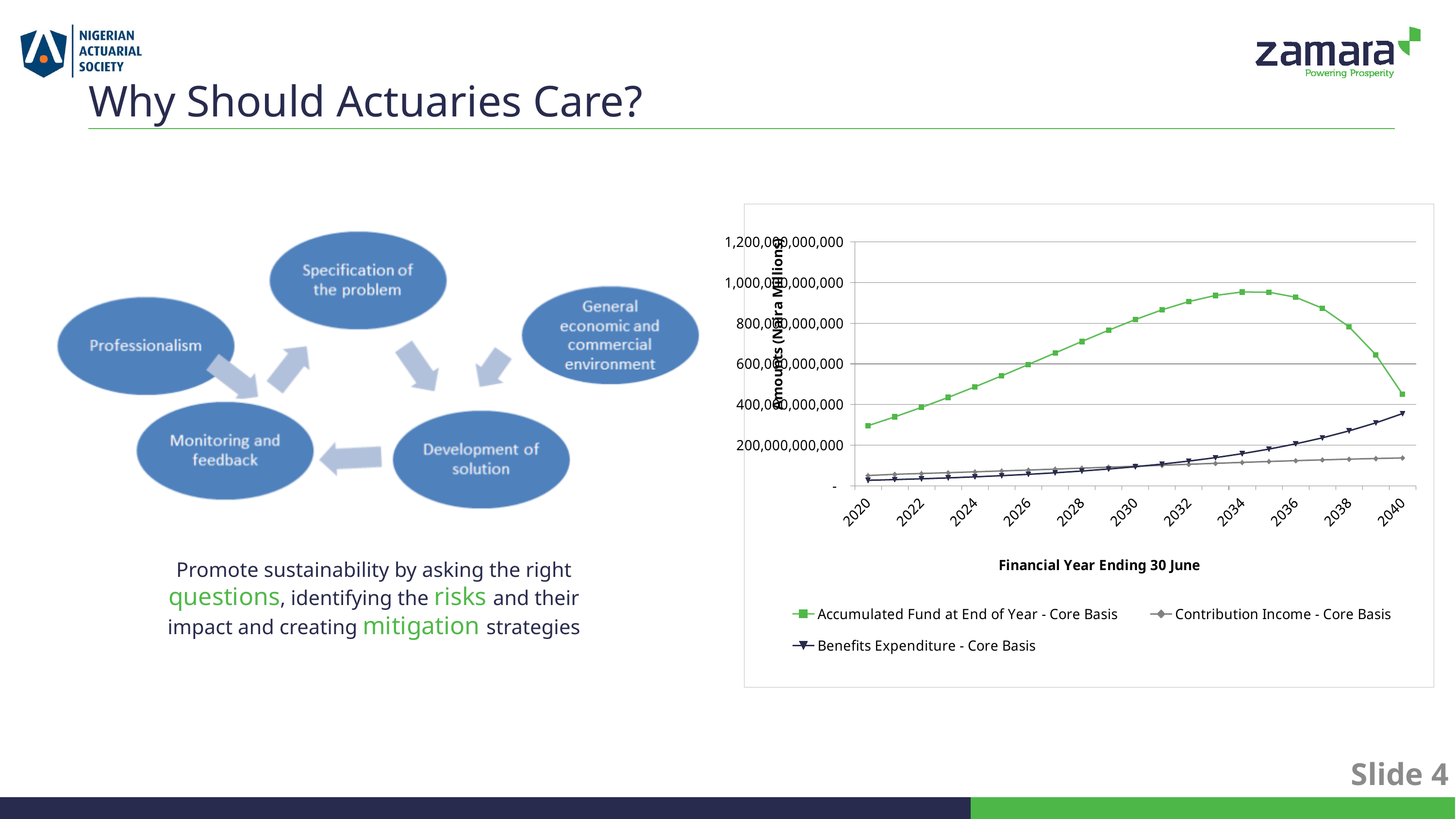
How many series does the chart legend list? 3 Is the value for Accumulated Fund at End of Year - Core Basis in 2020 greater or less than 400,000,000,000? less Does the Benefits Expenditure - Core Basis series rise or fall from 2020 to 2040? rise What kind of chart is shown on the right of the slide? line chart Which series has the highest value in 2030? Accumulated Fund at End of Year - Core Basis Which series has the lowest value in 2040? Contribution Income - Core Basis Is the value for Accumulated Fund at End of Year - Core Basis in 2040 greater or less than 600,000,000,000? less Is the value for Accumulated Fund at End of Year - Core Basis in 2034 greater or less than 800,000,000,000? greater Which series is plotted with green square markers? Accumulated Fund at End of Year - Core Basis What is the title of the chart's x axis? Financial Year Ending 30 June In 2040, which is larger: Benefits Expenditure - Core Basis or Contribution Income - Core Basis? Benefits Expenditure - Core Basis